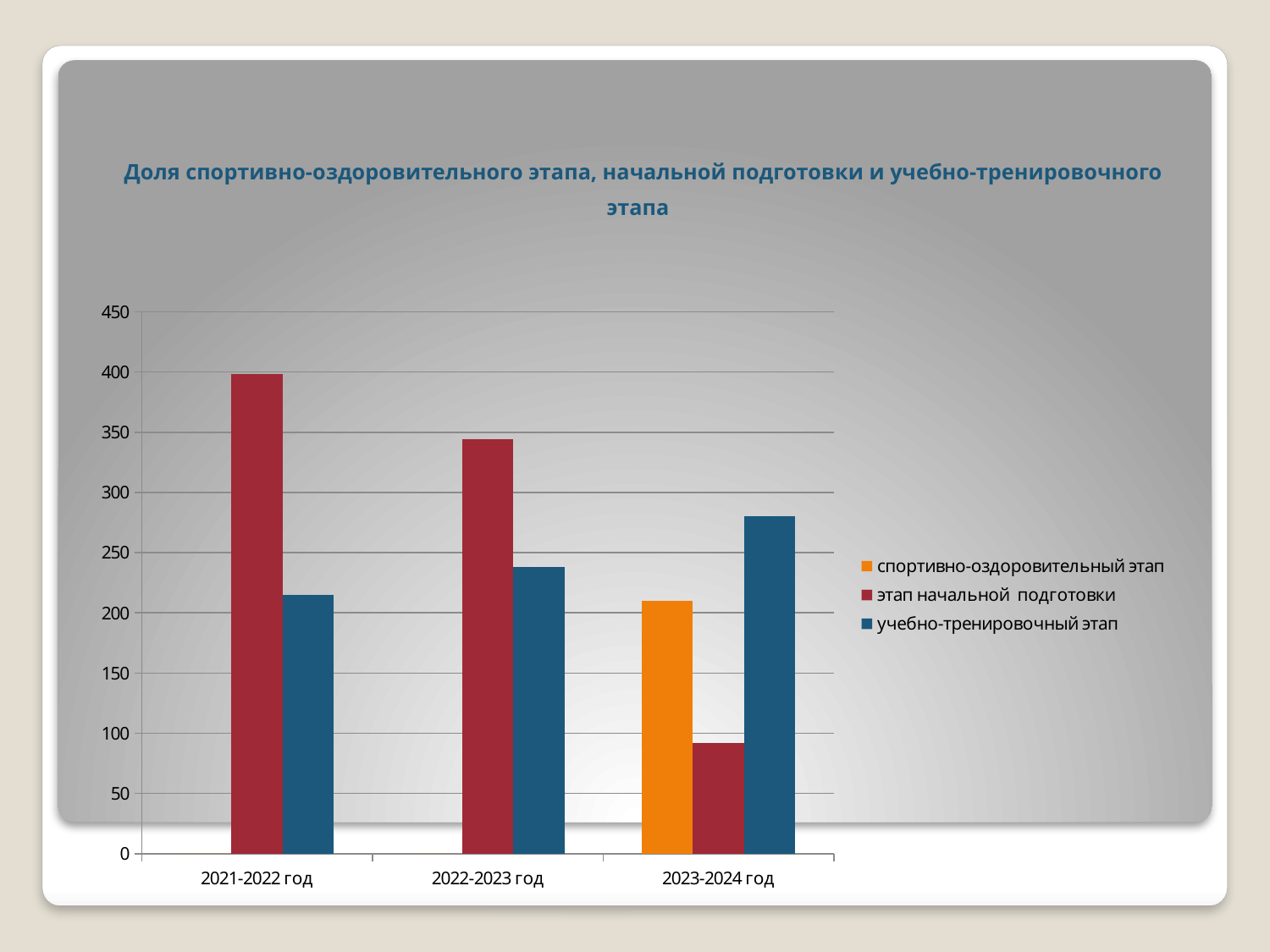
In which year is the value for этап начальной подготовки the lowest? 2023-2024 год In which year is the value for этап начальной подготовки the highest? 2021-2022 год What kind of chart is shown on the slide? bar chart Is the value for спортивно-оздоровительный этап in 2023-2024 год greater or less than 250? less Is the value for этап начальной подготовки in 2021-2022 год greater or less than 350? greater How many year categories are shown on the x axis? 3 In which year is the value for учебно-тренировочный этап the highest? 2023-2024 год Do the values for этап начальной подготовки rise or fall from 2021-2022 год to 2023-2024 год? fall How many series does the legend list? 3 In 2022-2023 год, which is larger: этап начальной подготовки or учебно-тренировочный этап? этап начальной подготовки Do the values for учебно-тренировочный этап rise or fall from 2021-2022 год to 2023-2024 год? rise Is the value for учебно-тренировочный этап in 2023-2024 год greater or less than 250? greater